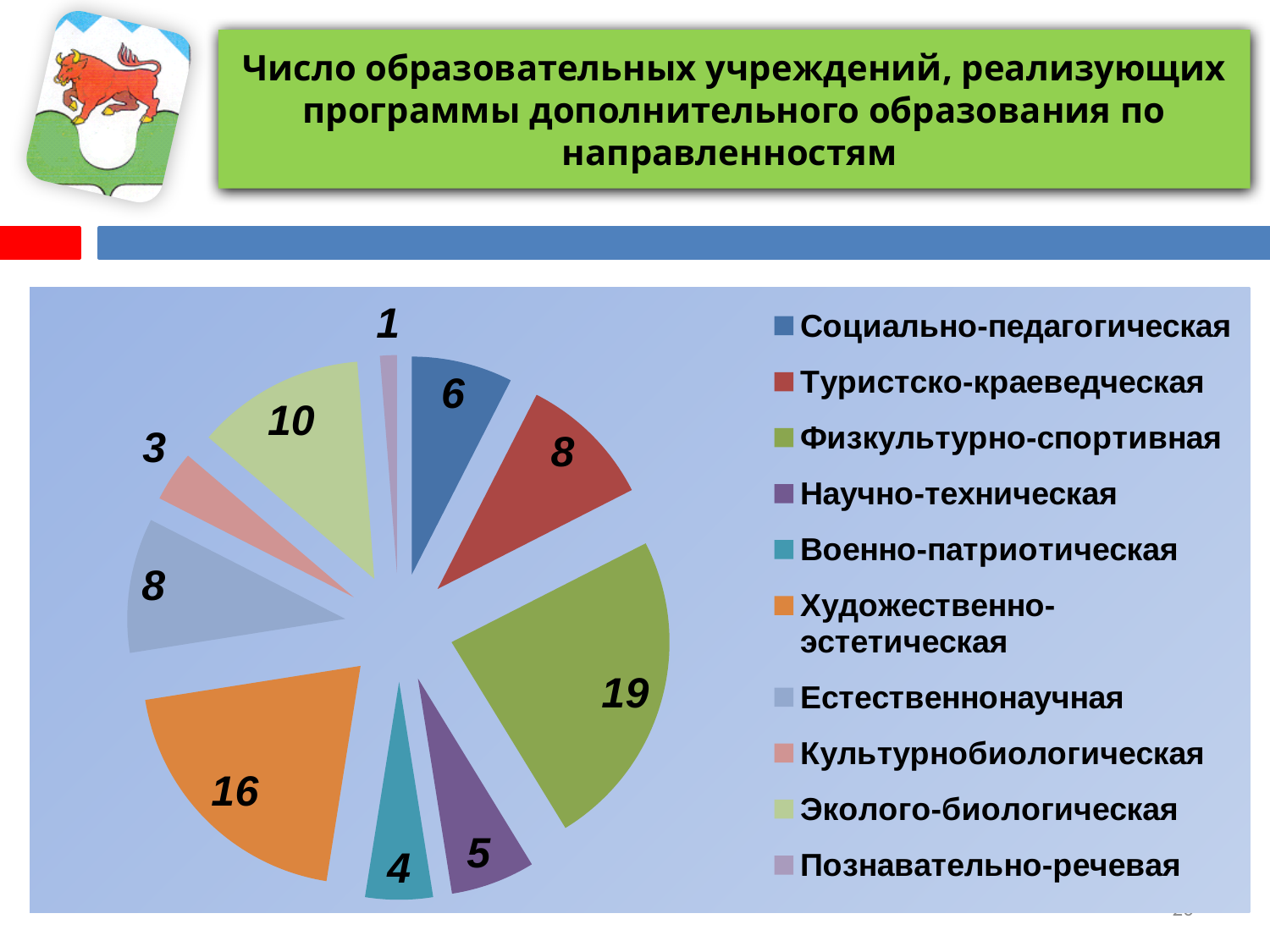
What is the value for Художественно-эстетическая? 16 Which category has the smallest slice of the pie? Познавательно-речевая Which category has the largest slice of the pie? Физкультурно-спортивная What is the difference between the values for Физкультурно-спортивная and Художественно-эстетическая? 3 Which is larger, the value for Социально-педагогическая or the value for Туристско-краеведческая? Туристско-краеведческая What is the title of the slide containing the pie chart? Число образовательных учреждений, реализующих программы дополнительного образования по направленностям How many categories does the legend of the pie chart list? 10 What is the value for Познавательно-речевая? 1 What type of chart is shown on the slide? pie chart What is the value for Эколого-биологическая? 10 What share of the pie does Художественно-эстетическая represent? 20% What is the value for Физкультурно-спортивная? 19